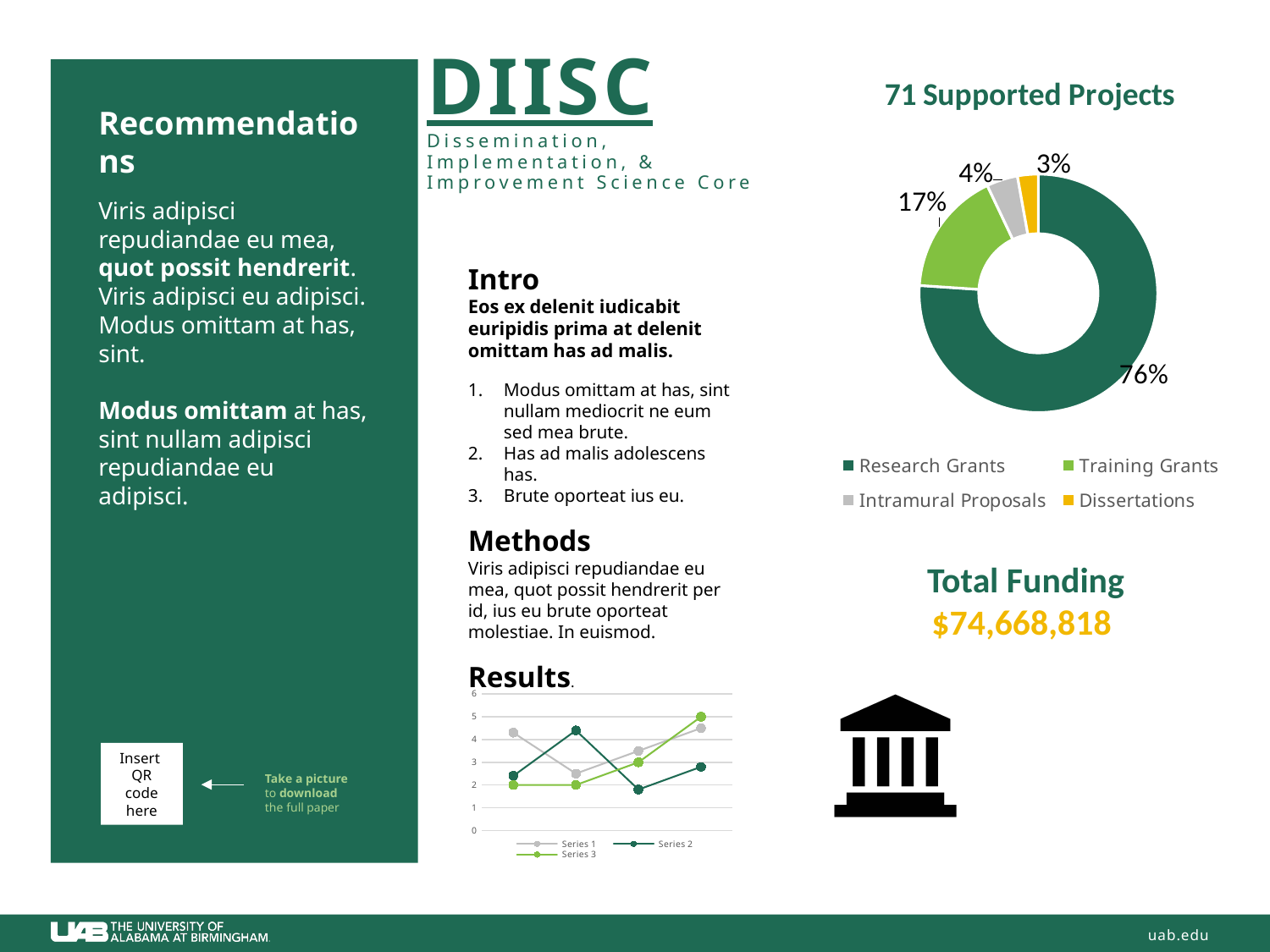
In the '71 Supported Projects' chart, what percentage is shown for Dissertations? 3% In the '71 Supported Projects' chart, what is the difference in percentage points between Research Grants and Training Grants? 59 In the '71 Supported Projects' chart, what percentage is shown for Research Grants? 76% In the '71 Supported Projects' chart, what percentage is shown for Intramural Proposals? 4% In the '71 Supported Projects' chart, how many categories does the legend list? 4 How many series does the legend of the 'Results' chart list? 3 In the '71 Supported Projects' chart, which category has the smallest share? Dissertations What kind of chart is the '71 Supported Projects' chart? Donut (pie) chart What kind of chart is shown under 'Results'? Line chart In the 'Results' chart, is the first value of Series 1 greater or less than 4? greater In the '71 Supported Projects' chart, which category has the largest share? Research Grants In the '71 Supported Projects' chart, what percentage is shown for Training Grants? 17%